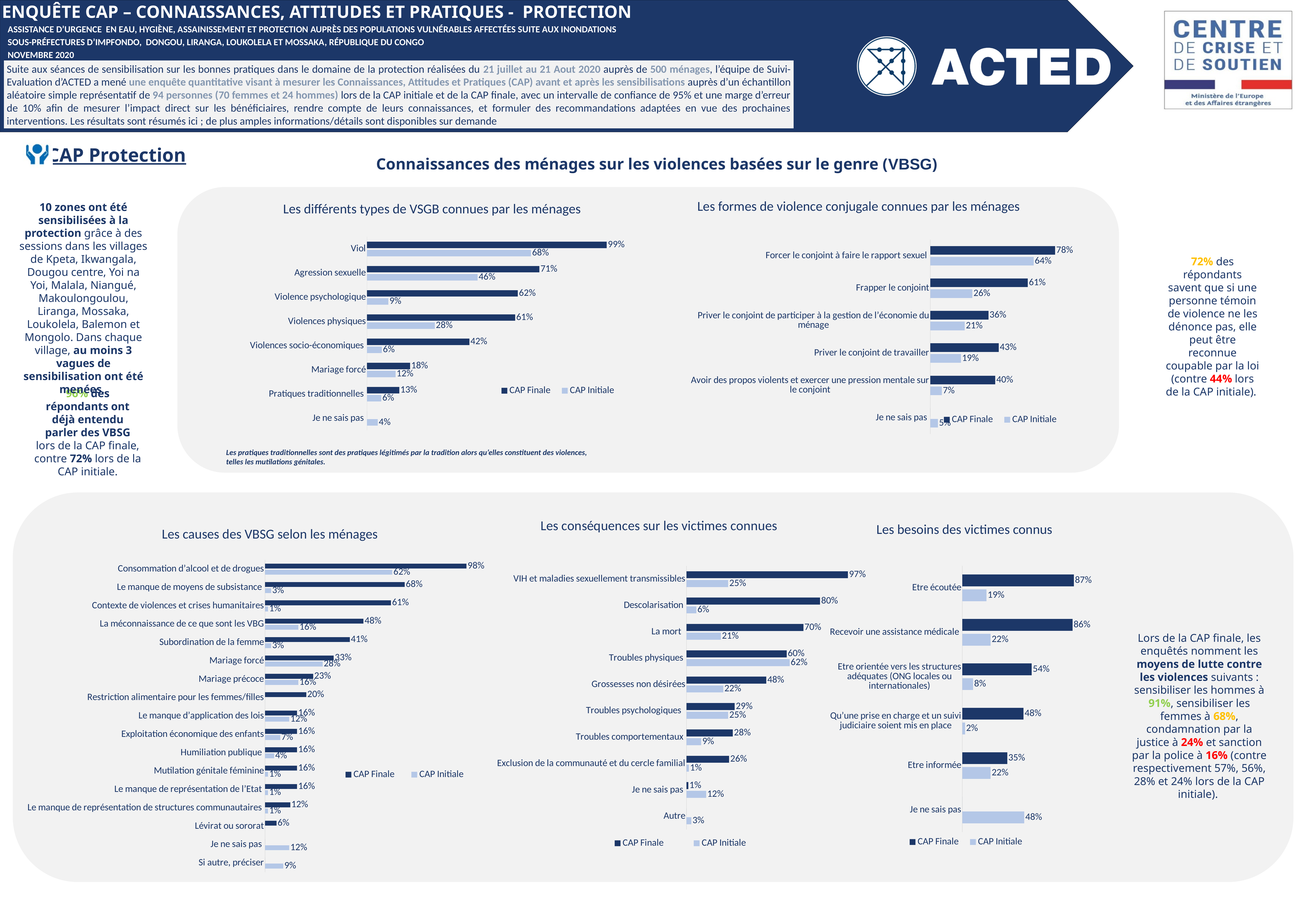
In the chart 'Les différents types de VSGB connues par les ménages', what is the CAP Finale value for Viol? 99% In the chart 'Les causes des VBSG selon les ménages', what is the CAP Finale value for Consommation d'alcool et de drogues? 98% In the chart 'Les formes de violence conjugale connues par les ménages', which category has the highest CAP Finale value? Forcer le conjoint à faire le rapport sexuel What type of chart is 'Les causes des VBSG selon les ménages'? Bar chart In the chart 'Les besoins des victimes connus', what is the difference between the CAP Finale and CAP Initiale values for Recevoir une assistance médicale? 64% In the chart 'Les formes de violence conjugale connues par les ménages', what is the CAP Initiale value for Frapper le conjoint? 26% In the chart 'Les besoins des victimes connus', what is the CAP Finale value for Etre écoutée? 87% In the chart 'Les différents types de VSGB connues par les ménages', what is the difference between the CAP Finale and CAP Initiale values for Violence psychologique? 53% How many series does the legend list in the chart 'Les différents types de VSGB connues par les ménages'? 2 In the chart 'Les causes des VBSG selon les ménages', which is larger: the CAP Finale value for Mariage forcé or the CAP Finale value for Mariage précoce? Mariage forcé In the chart 'Les conséquences sur les victimes connues', which category has the highest CAP Finale value? VIH et maladies sexuellement transmissibles In the chart 'Les conséquences sur les victimes connues', what is the CAP Initiale value for Troubles physiques? 62%